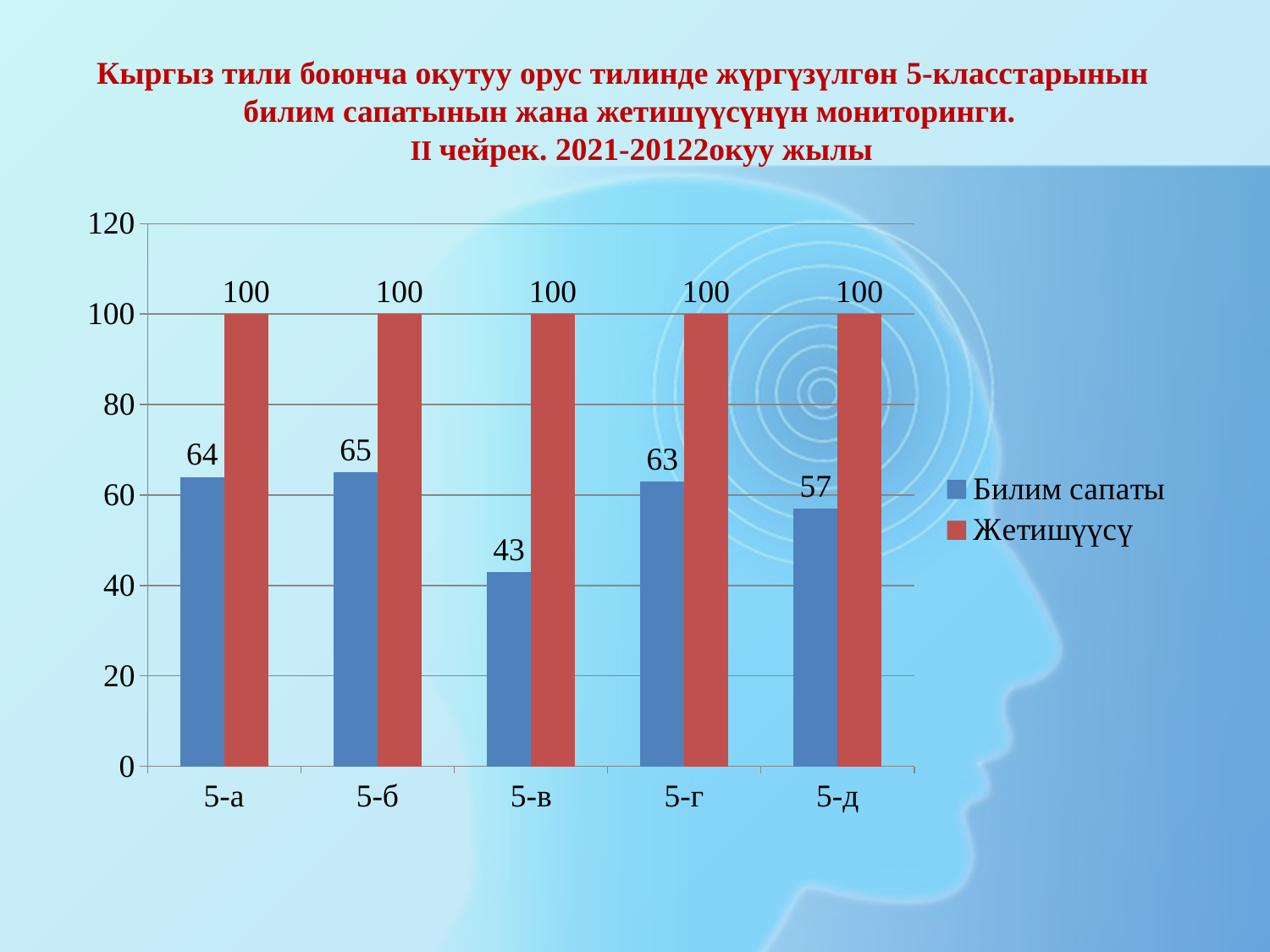
How many series does the legend list? 2 What is the difference between Жетишүүсү and Билим сапаты for 5-д? 43 What kind of chart is shown on the slide? bar chart What is the value of Жетишүүсү for 5-д? 100 How many classes are shown on the x axis? 5 Which colour represents Жетишүүсү in the chart? red What is the difference between the Билим сапаты values for 5-б and 5-в? 22 What is the value of Билим сапаты for 5-а? 64 Which class has the highest Билим сапаты value? 5-б Which class has the lowest Билим сапаты value? 5-в Which is larger, the Билим сапаты value for 5-г or for 5-д? 5-г What is the value of Билим сапаты for 5-в? 43